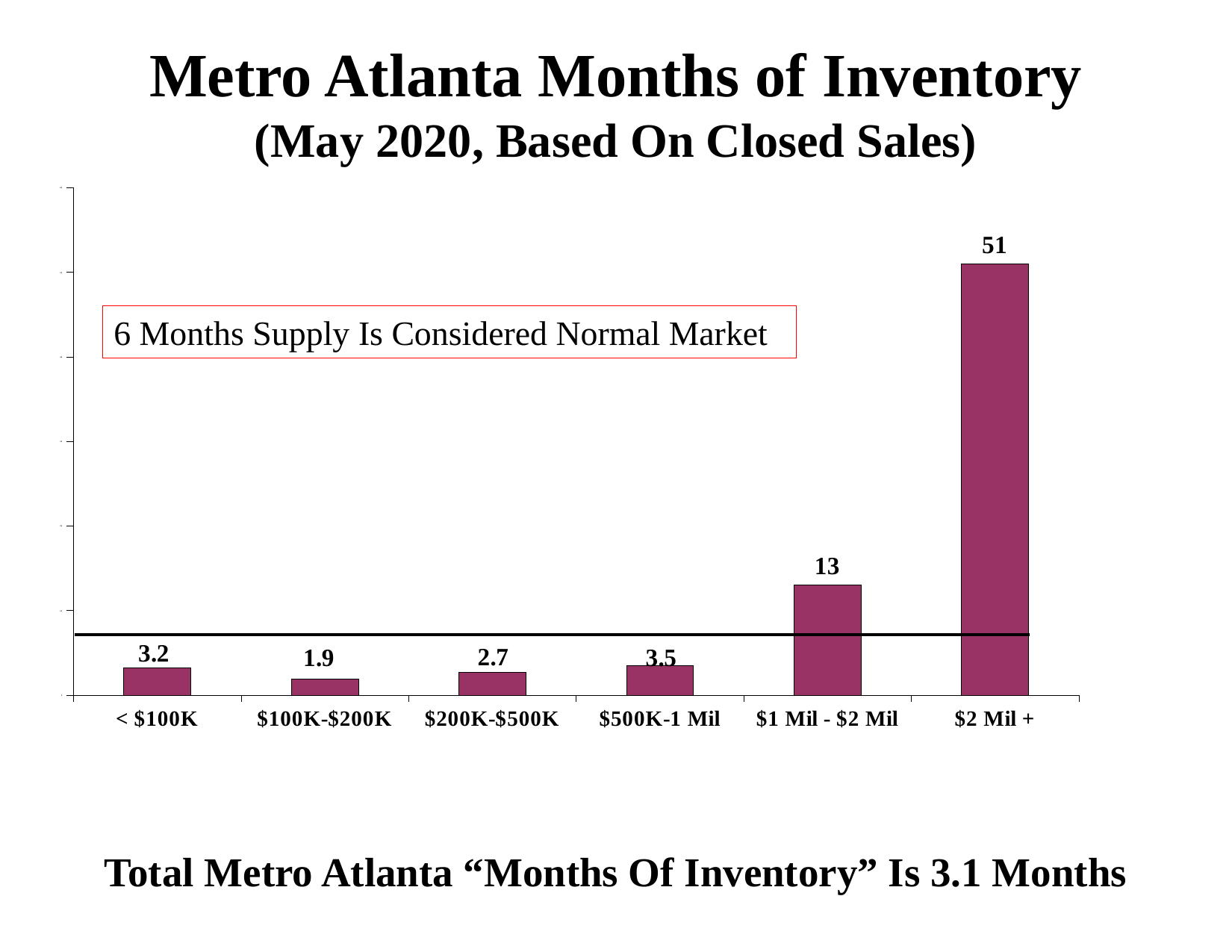
Which price range has the highest months of inventory? $2 Mil + Which price range has the lowest months of inventory? $100K-$200K How many price range categories are shown on the chart? 6 What type of chart is shown on the slide? Bar chart What is the difference in months of inventory between the $2 Mil + and $1 Mil - $2 Mil price ranges? 38 What is the months of inventory value for the < $100K price range? 3.2 According to the text box on the chart, how many months of supply is considered a normal market? 6 Months Which has a larger months of inventory value, < $100K or $200K-$500K? < $100K What is the months of inventory value for the $2 Mil + price range? 51 What is the months of inventory value for the $1 Mil - $2 Mil price range? 13 What is the difference in months of inventory between the $500K-1 Mil and $200K-$500K price ranges? 0.8 What is the months of inventory value for the $100K-$200K price range? 1.9